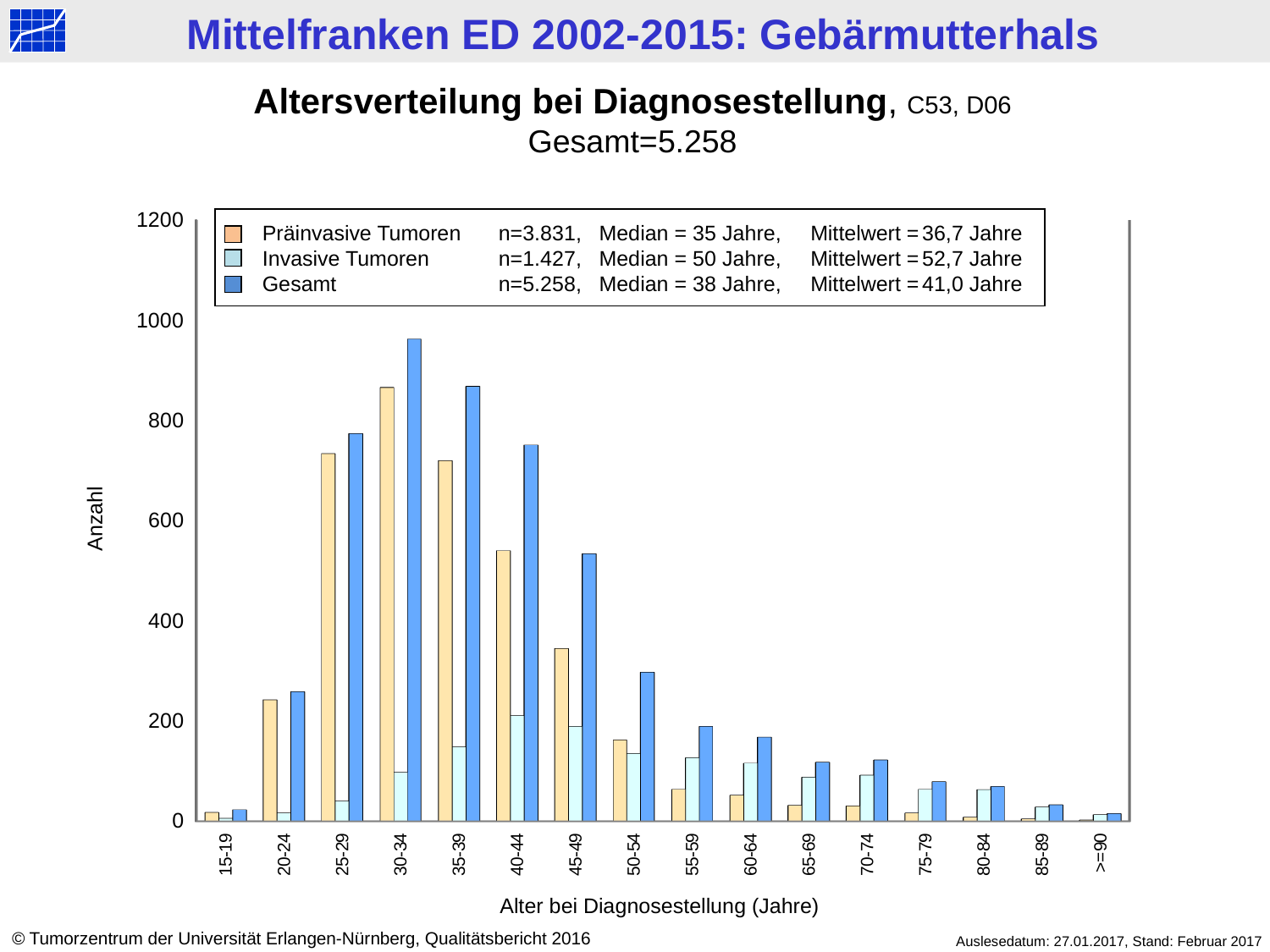
What kind of chart is shown on the slide? bar chart In the 45-49 category, which is larger, Präinvasive Tumoren or Invasive Tumoren? Präinvasive Tumoren Which age category has the highest value for Präinvasive Tumoren? 30-34 Is the Gesamt value for 30-34 greater or less than 800? greater Which is larger, the Gesamt value for 35-39 or for 40-44? 35-39 Do the Gesamt values rise or fall along the x axis from 30-34 to >=90? fall According to the legend, what is the median age for Invasive Tumoren? 50 Jahre Which age category has the highest Gesamt value? 30-34 How many series does the legend list? 3 Is the value for Invasive Tumoren in the 35-39 category greater or less than 200? less Is the value for Präinvasive Tumoren in the 25-29 category greater or less than 600? greater How many age categories are shown on the x axis? 16